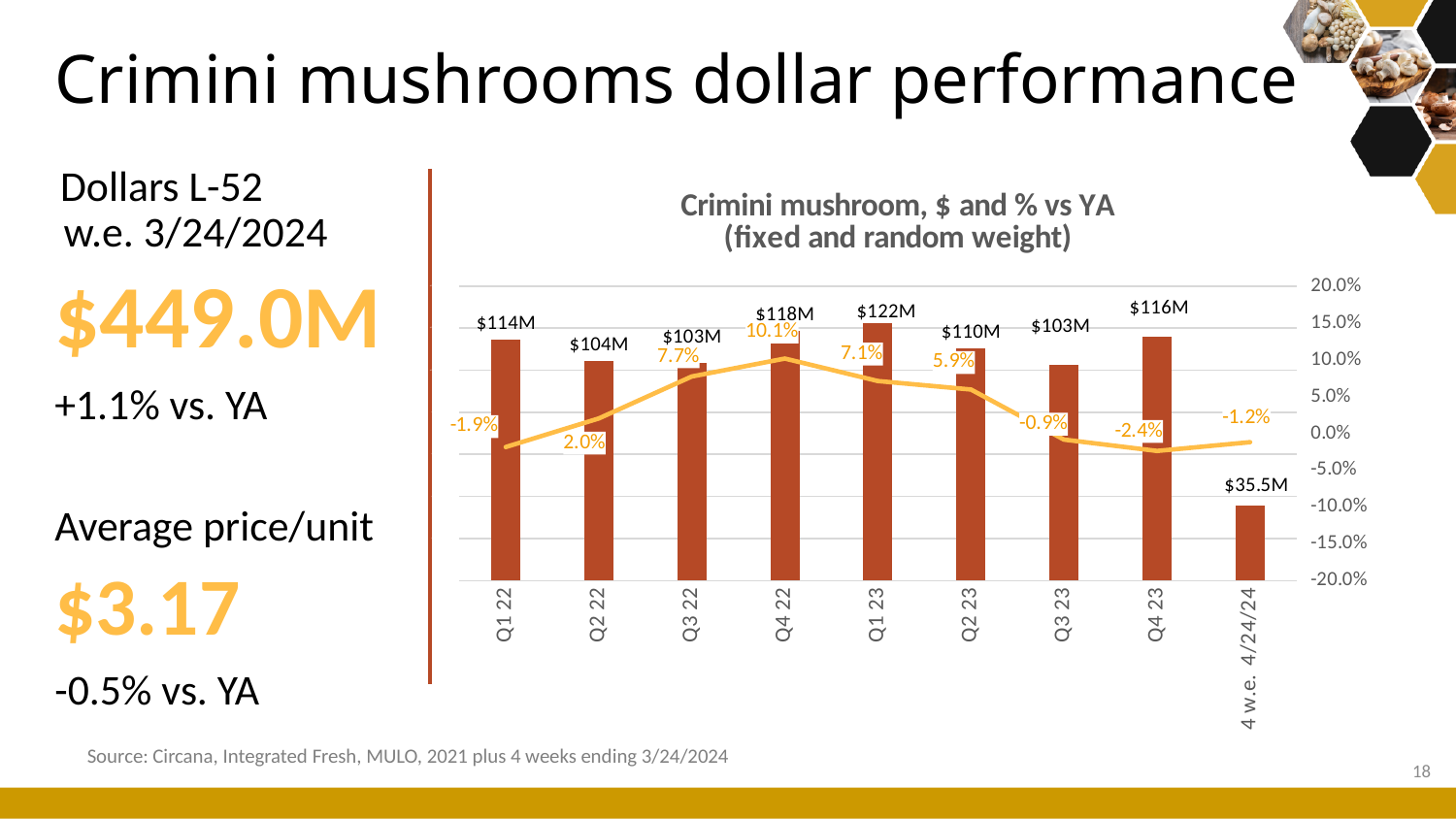
What kind of chart is this? Combination bar and line chart What is the % vs YA value shown for Q4 23? -2.4% What is the difference in dollars between Q1 23 and Q2 23? $12M Which is larger, the dollar value for Q4 22 or for Q4 23? Q4 22 What is the % vs YA value shown for Q4 22? 10.1% Which period has the lowest % vs YA value on the line? Q4 23 What is the dollar value shown for Q1 23? $122M Which quarter has the highest dollar value? Q1 23 Is the % vs YA value for Q3 22 greater or less than 5.0%? greater What is the dollar value shown for the 4 w.e. 4/24/24 period? $35.5M How many periods are shown on the x axis? 9 What is the title of the chart? Crimini mushroom, $ and % vs YA (fixed and random weight)